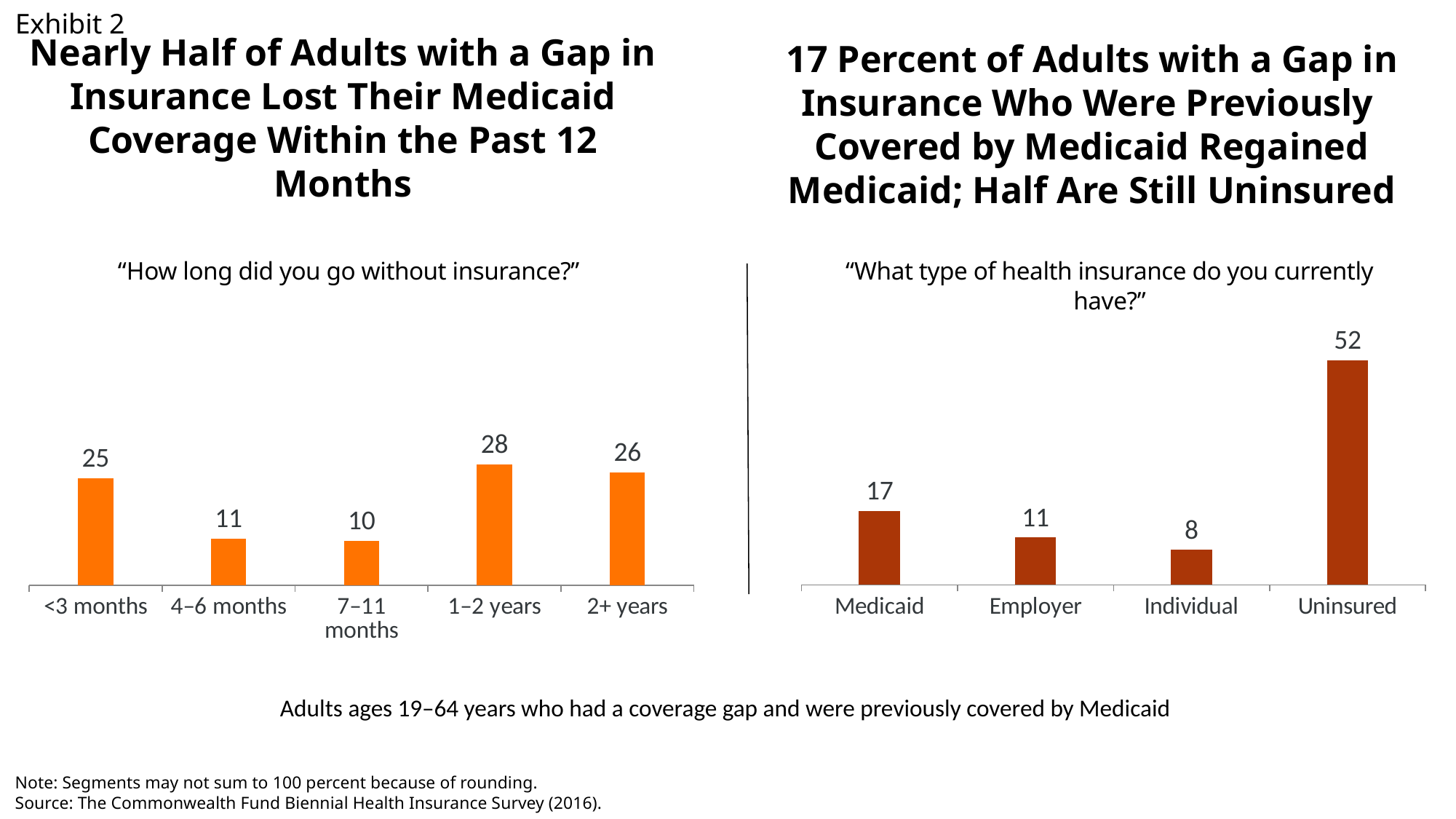
In the left chart ("How long did you go without insurance?"), what is the value for 1–2 years? 28 In the right chart ("What type of health insurance do you currently have?"), what is the value for Medicaid? 17 In the right chart ("What type of health insurance do you currently have?"), what is the value for Individual? 8 In the right chart ("What type of health insurance do you currently have?"), what is the difference between the values for Uninsured and Employer? 41 In the left chart ("How long did you go without insurance?"), what is the difference between the values for 2+ years and 4–6 months? 15 In the left chart ("How long did you go without insurance?"), which category has the lowest value? 7–11 months What kind of chart is the right chart ("What type of health insurance do you currently have?")? Bar chart In the left chart ("How long did you go without insurance?"), which category has the highest value? 1–2 years In the right chart ("What type of health insurance do you currently have?"), which is larger, the value for Medicaid or the value for Employer? Medicaid In the left chart ("How long did you go without insurance?"), how many categories are shown? 5 In the left chart ("How long did you go without insurance?"), what is the value for <3 months? 25 In the right chart ("What type of health insurance do you currently have?"), which category has the highest value? Uninsured